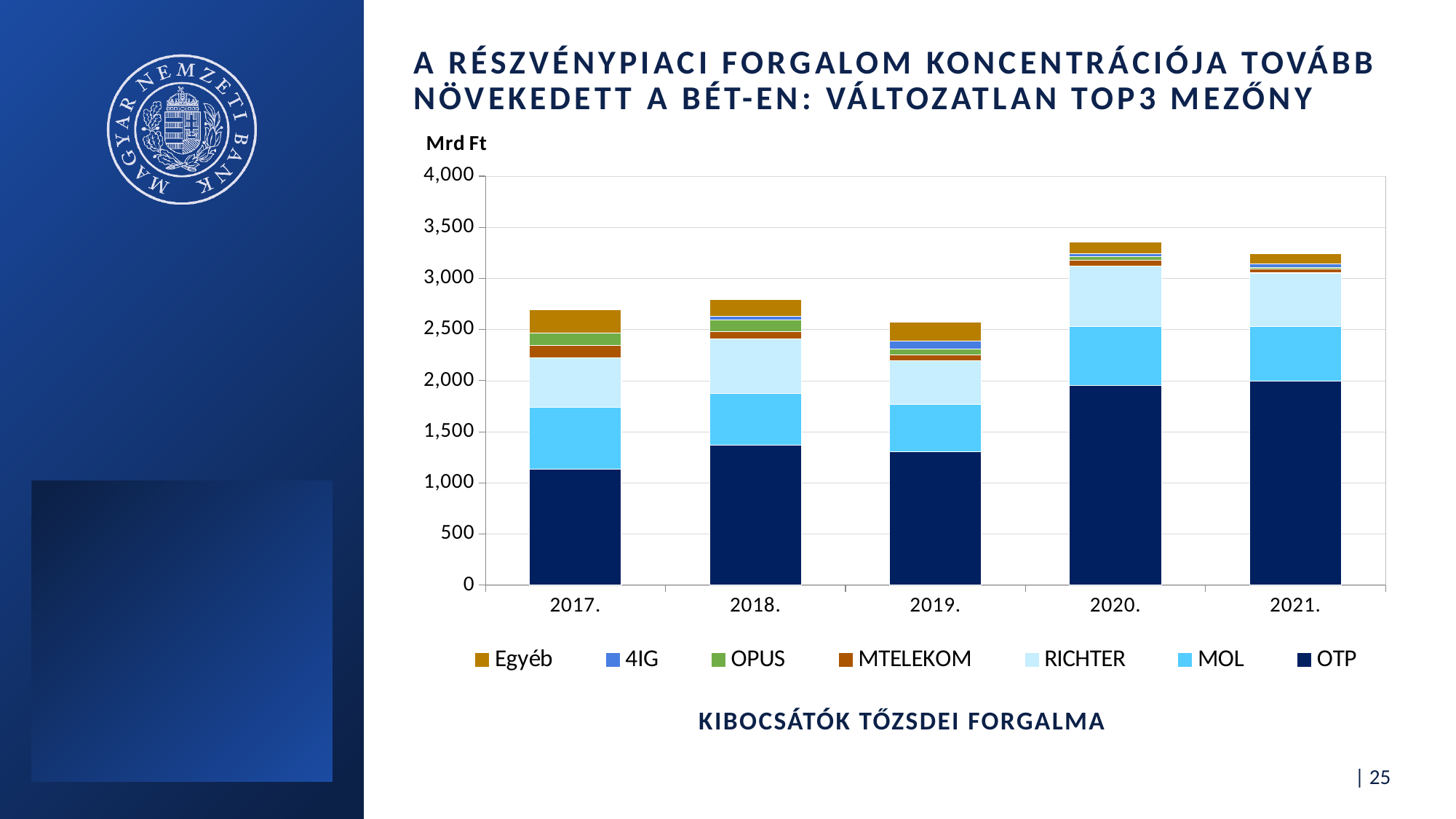
What unit is shown above the vertical axis of the chart? Mrd Ft Is the total stacked value for 2020. greater or less than 3,000? greater What kind of chart is shown on the slide? stacked bar chart How many series does the chart legend list? 7 Is the OTP value for 2017. greater or less than 1,000? greater Which year has the highest total stacked bar? 2020. What is the caption shown below the chart legend? KIBOCSÁTÓK TŐZSDEI FORGALMA Which is larger, the OTP value for 2021. or the OTP value for 2017.? 2021. Which year has the lowest total stacked bar? 2019. Is the total stacked value for 2019. greater or less than 3,000? less How many years are shown on the x axis of the chart? 5